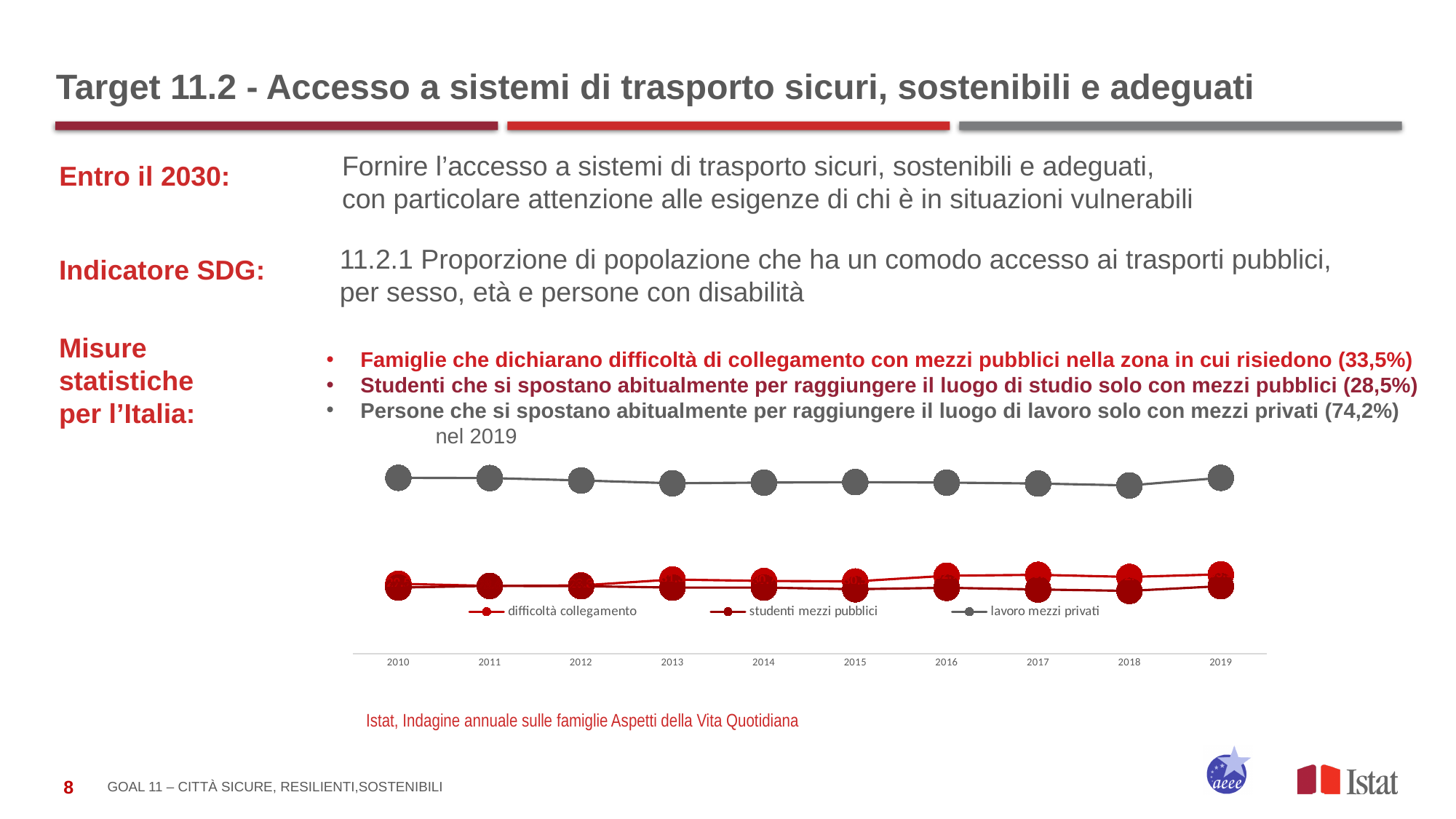
According to the slide, what is the 2019 value for students travelling to their place of study only by public transport (studenti mezzi pubblici)? 28,5% How many years are shown on the x axis of the chart? 10 In 2019, which is larger: the value for lavoro mezzi privati or the value for difficoltà collegamento? lavoro mezzi privati According to the slide, what is the 2019 value for people travelling to work only by private means (lavoro mezzi privati)? 74,2% Which series in the chart has the highest values across all years? lavoro mezzi privati How many series does the chart legend list? 3 According to the slide, what is the 2019 value for families declaring difficulty of connection with public transport (difficoltà collegamento)? 33,5% What is the last year shown on the x axis of the chart? 2019 What kind of chart is shown on the slide? line chart In 2010, which is larger: the value for lavoro mezzi privati or the value for studenti mezzi pubblici? lavoro mezzi privati What is the first year shown on the x axis of the chart? 2010 What is the difference between the 2019 values for lavoro mezzi privati (74,2%) and difficoltà collegamento (33,5%)? 40,7 percentage points